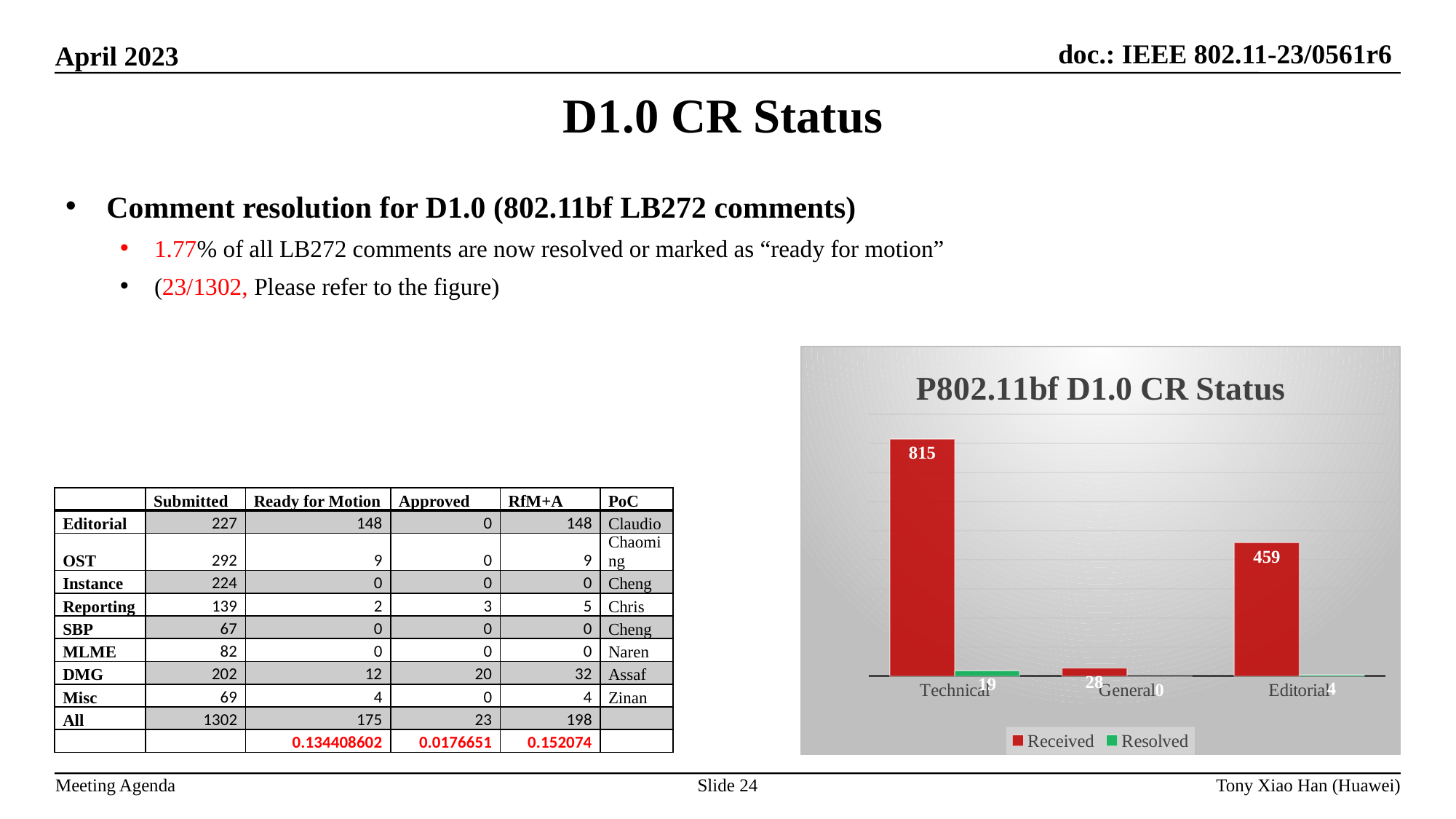
How many categories are shown on the x axis of the chart? 3 What is the title of the chart on the slide? P802.11bf D1.0 CR Status What is the Received value for Technical in the chart? 815 What is the difference between the Received values for Technical and Editorial in the chart? 356 How many series does the chart legend list? 2 What type of chart is shown on the slide? bar chart Which category has the highest Received value in the chart? Technical What is the Resolved value for Technical in the chart? 19 Which series is shown in red in the chart? Received What is the Received value for Editorial in the chart? 459 Which category has the lowest Received value in the chart? General What is the Received value for General in the chart? 28